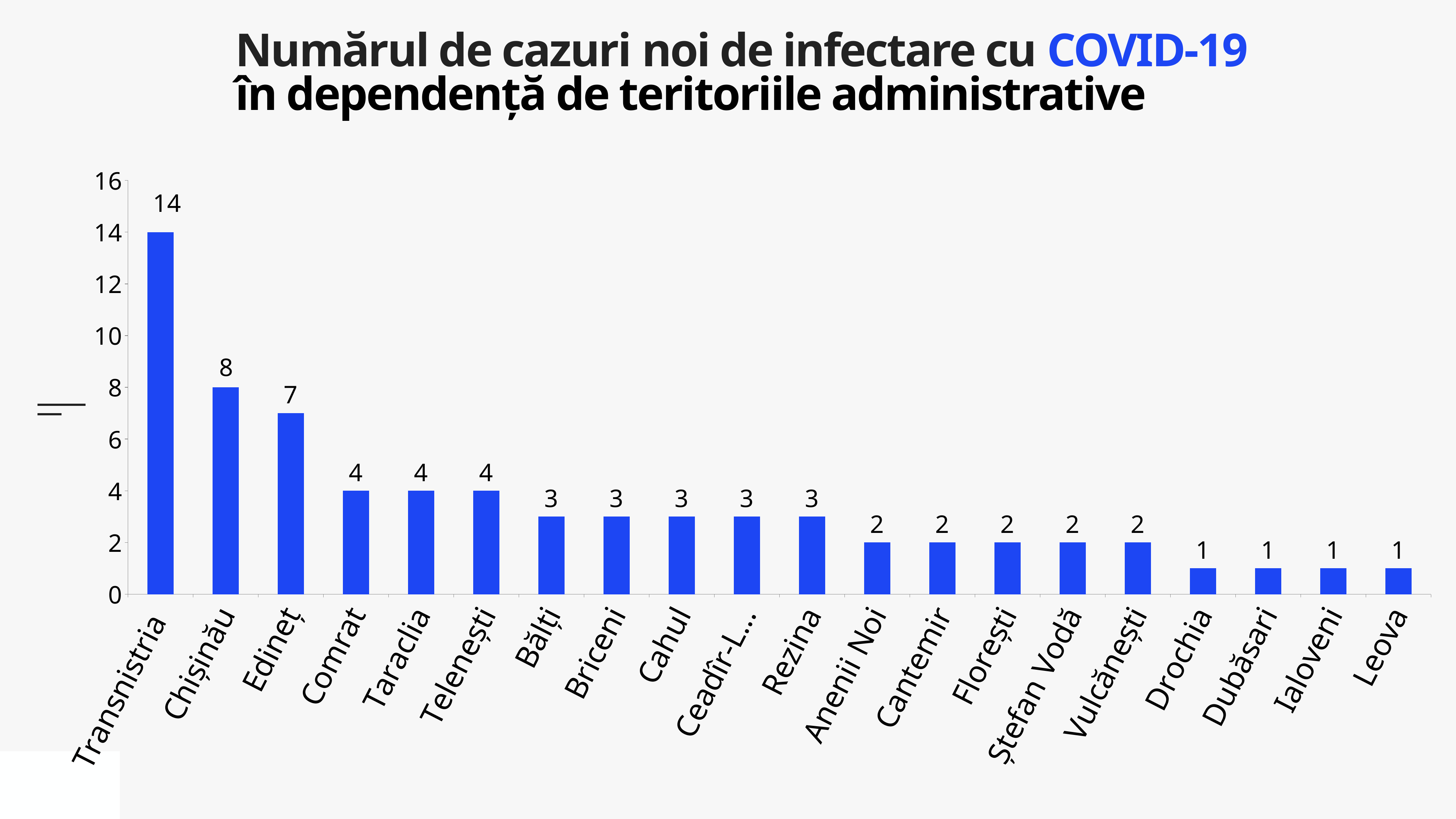
How many categories are shown on the x axis? 20 Which category has the highest value? Transnistria What is the value for Ștefan Vodă? 2 What is the difference between the values for Edineț and Comrat? 3 What is the difference between the values for Transnistria and Chișinău? 6 What is the value for Rezina? 3 What is the value for Edineț? 7 What is the value for Chișinău? 8 Which is larger, the value for Chișinău or the value for Bălți? Chișinău Do the values rise or fall from left to right along the x axis? Fall What kind of chart is shown on the slide? Bar chart What is the value for Transnistria? 14